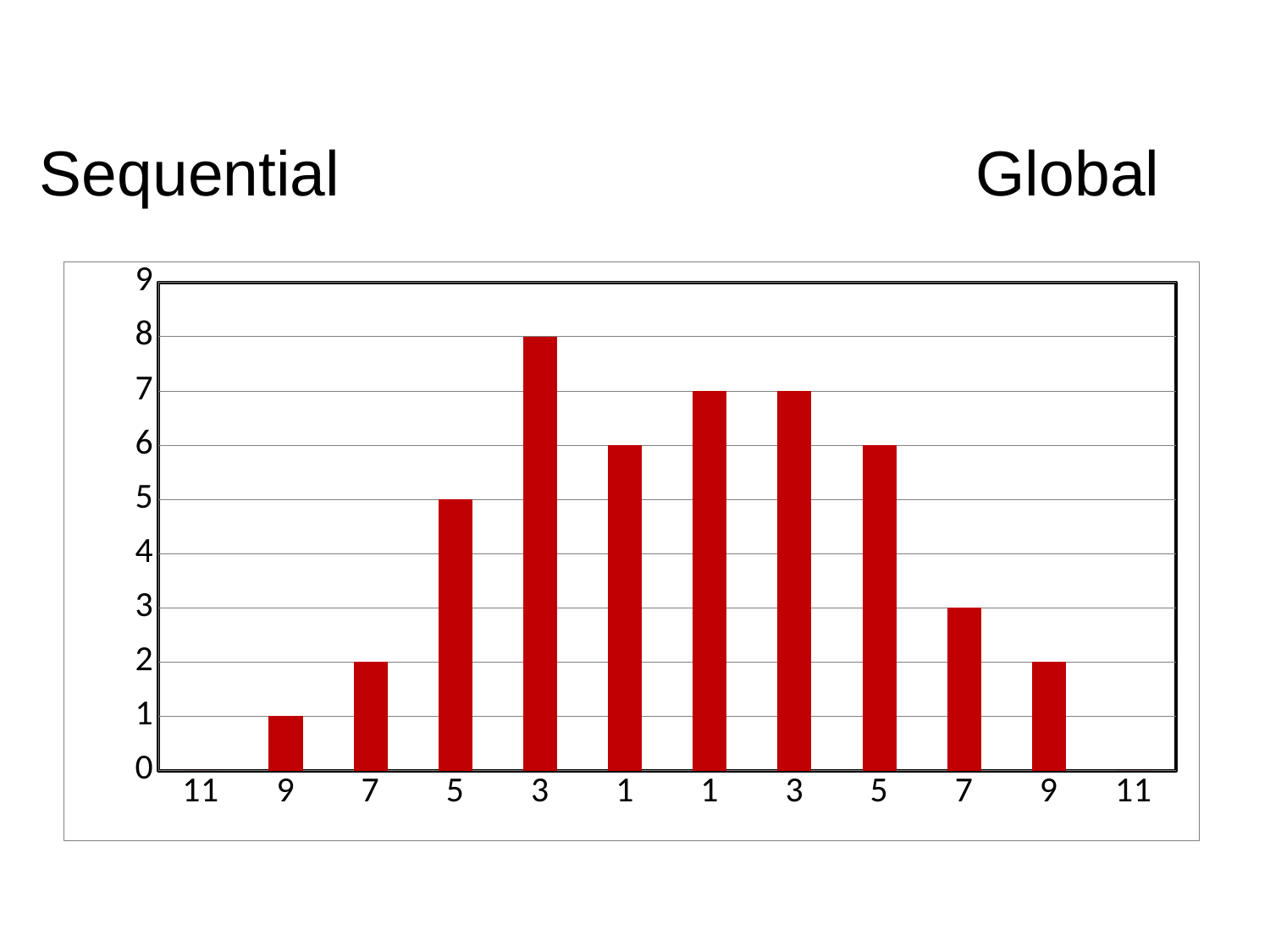
Do the bar values rise or fall moving from category 11 to category 3 on the Sequential (left) side of the chart? rise What colour are the bars in the chart? red How many categories are shown along the x axis of the chart? 12 What is the value of the bar at category 5 on the Sequential (left) side of the chart? 5 What is the value of the bar at category 3 on the Sequential (left) side of the chart? 8 What is the value of the bar at category 9 on the Sequential (left) side of the chart? 1 What type of chart is shown on the slide? bar chart What is the value of the bar at category 1 on the Global (right) side of the chart? 7 Which is larger: the bar at category 1 on the Sequential (left) side or the bar at category 1 on the Global (right) side? Global (right) side What is the difference between the bar at category 3 and the bar at category 5 on the Sequential (left) side of the chart? 3 What is the value of the bar at category 7 on the Global (right) side of the chart? 3 What is the highest value reached by any bar in the chart? 8